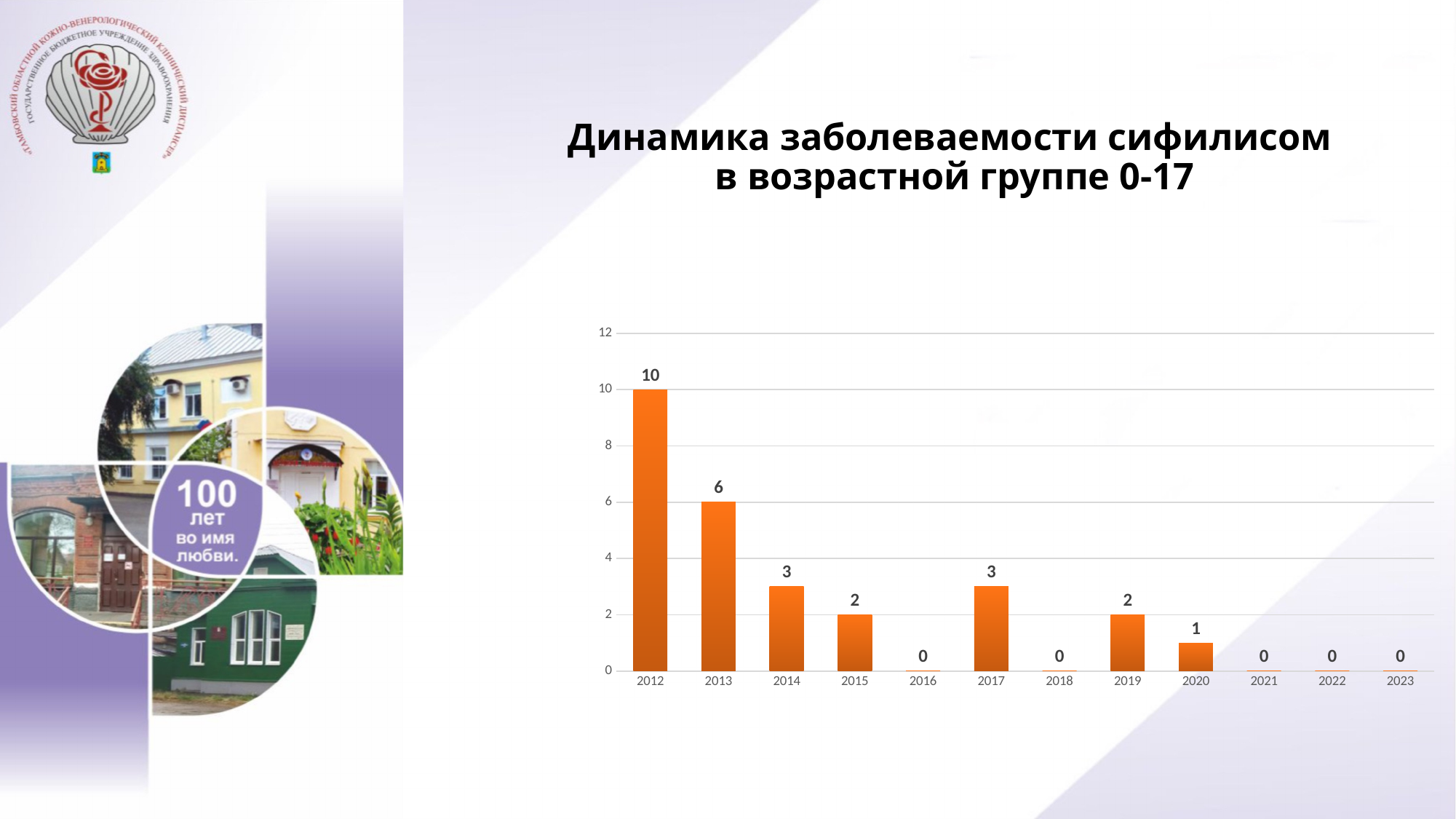
What is the value for 2013? 6 Which year has the highest value? 2012 What is the difference between the values for 2014 and 2015? 1 What kind of chart is shown on the slide? bar chart What is the value for 2017? 3 What is the value for 2020? 1 Which is larger, the value for 2019 or the value for 2020? 2019 What is the difference between the values for 2012 and 2013? 4 How many years have a value of 0? 5 What is the title of the chart on the slide? Динамика заболеваемости сифилисом в возрастной группе 0-17 What is the value for 2012? 10 How many years are shown on the x axis? 12